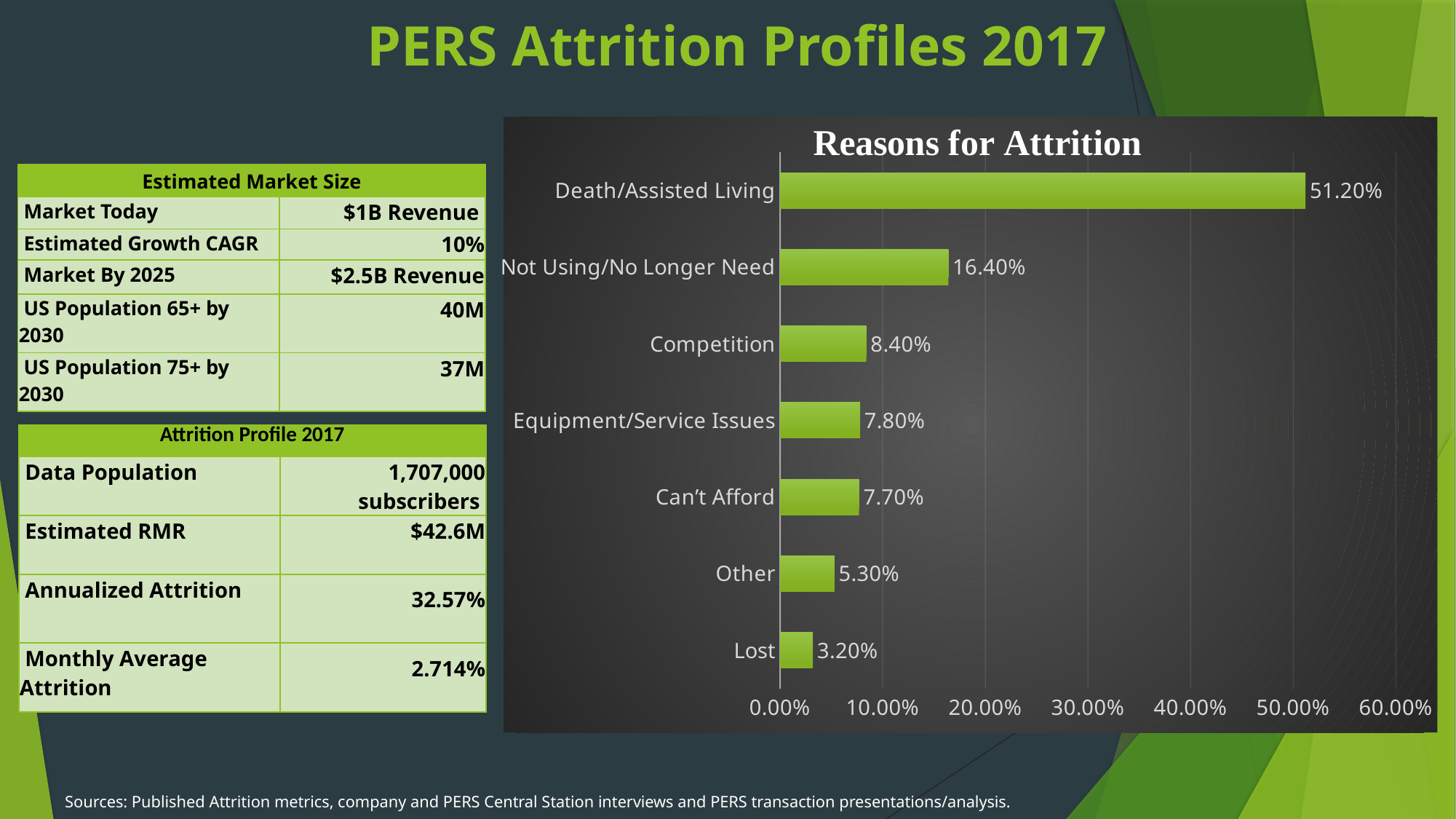
Which reason has the highest value in the Reasons for Attrition chart? Death/Assisted Living What is the difference between Death/Assisted Living and Not Using/No Longer Need in the Reasons for Attrition chart? 34.80% Which is larger in the Reasons for Attrition chart: Competition or Other? Competition What is the value for Lost in the Reasons for Attrition chart? 3.20% What is the value for Death/Assisted Living in the Reasons for Attrition chart? 51.20% What is the difference between Equipment/Service Issues and Can't Afford in the Reasons for Attrition chart? 0.10% What kind of chart is the Reasons for Attrition chart? bar chart How many reasons are shown in the Reasons for Attrition chart? 7 What is the title of the chart on the slide? Reasons for Attrition Is the value for Not Using/No Longer Need greater or less than 20.00%? less Which reason has the lowest value in the Reasons for Attrition chart? Lost What is the value for Competition in the Reasons for Attrition chart? 8.40%